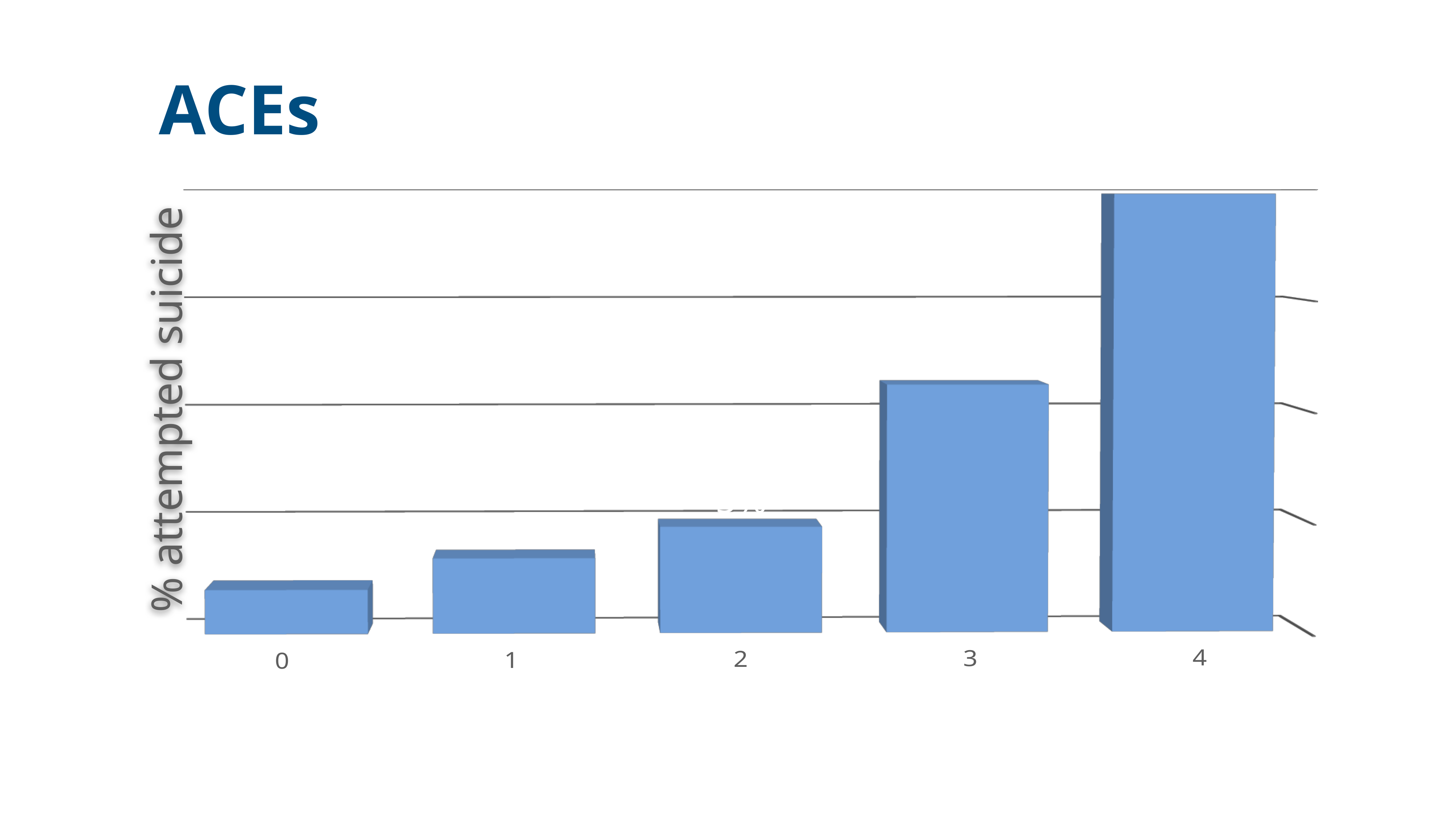
What kind of chart is shown on the slide? bar chart Which bar is taller, the one for category 1 or the one for category 0? 1 Do the bar values rise or fall as you move from category 0 to category 4 along the x axis? rise What is the title shown above the chart on the slide? ACEs Which category has the lowest bar in the chart? 0 Which bar is taller, the one for category 3 or the one for category 2? 3 What is the label on the vertical axis of the chart? % attempted suicide Which bar is taller, the one for category 4 or the one for category 3? 4 Which category has the highest bar in the chart? 4 How many bars (categories) are plotted in the chart? 5